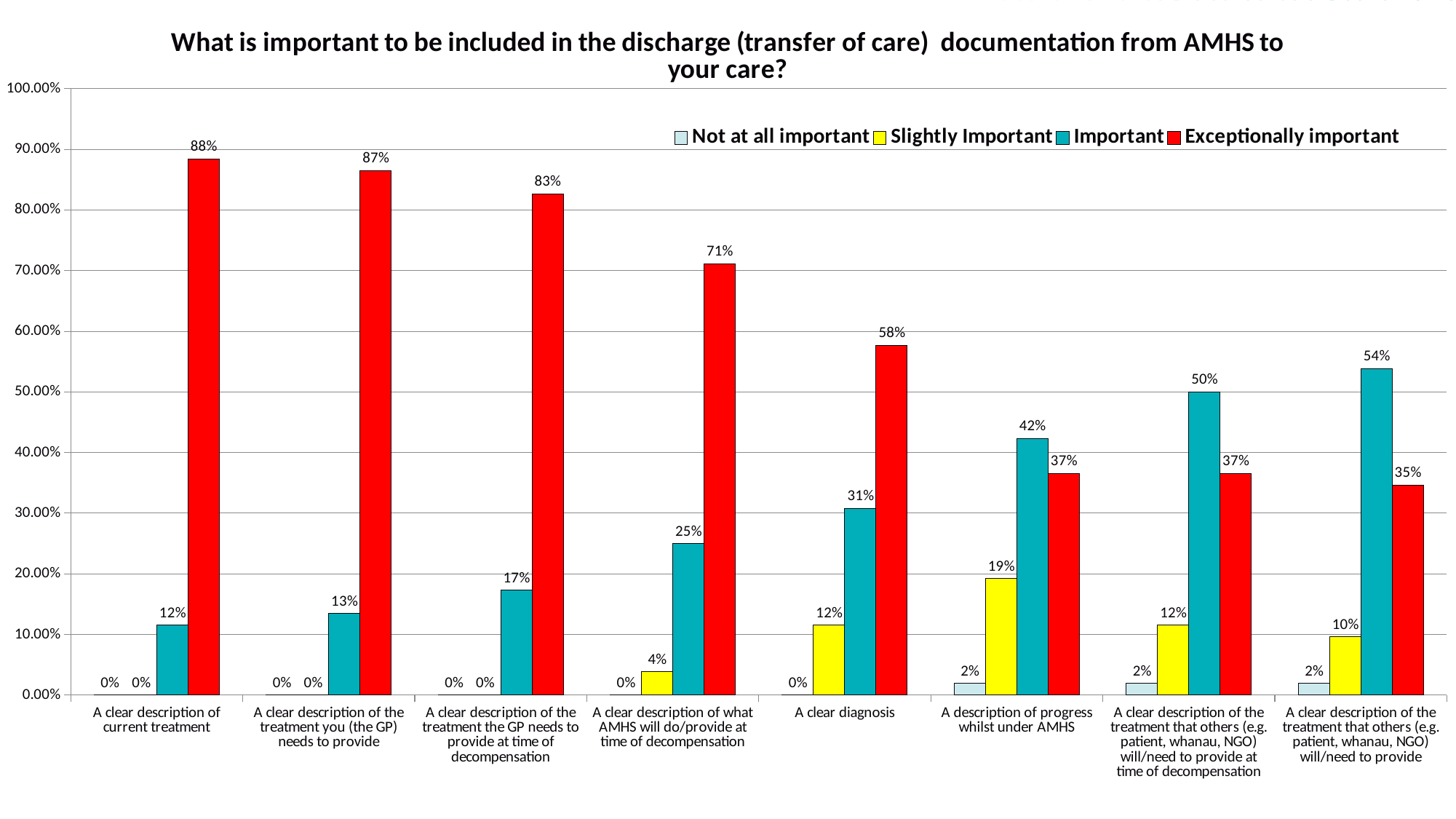
Which category has the highest 'Important' value? A clear description of the treatment that others (e.g. patient, whanau, NGO) will/need to provide Which series is shown in red? Exceptionally important How many categories are shown on the x axis? 8 What is the difference between the 'Exceptionally important' values for 'A clear description of current treatment' and 'A clear diagnosis'? 30% What is the 'Exceptionally important' value for 'A clear description of current treatment'? 88% What is the 'Slightly Important' value for 'A description of progress whilst under AMHS'? 19% Is the 'Exceptionally important' value for 'A clear description of what AMHS will do/provide at time of decompensation' greater or less than 60.00%? greater For 'A description of progress whilst under AMHS', which is larger: the 'Important' value or the 'Exceptionally important' value? Important How many series does the legend list? 4 Which category has the lowest 'Exceptionally important' value? A clear description of the treatment that others (e.g. patient, whanau, NGO) will/need to provide What kind of chart is shown on the slide? bar chart What is the 'Important' value for 'A clear diagnosis'? 31%